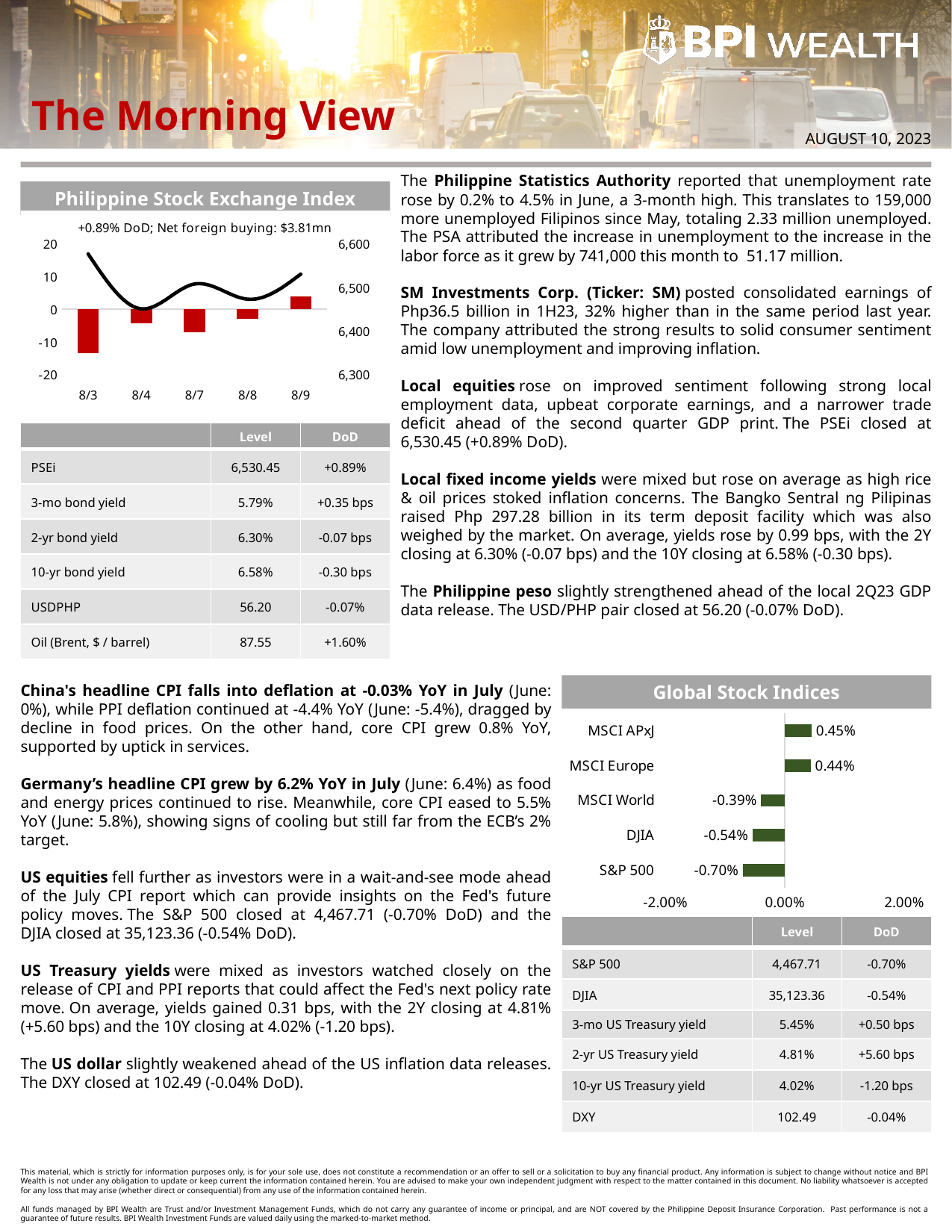
On the Global Stock Indices chart, what is the difference between the MSCI Europe value and the MSCI World value? 0.83 percentage points On the Global Stock Indices chart, what is the value for DJIA? -0.54% How many indices are plotted on the Global Stock Indices chart? 5 How many dates are shown on the x axis of the Philippine Stock Exchange Index chart? 5 On the Global Stock Indices chart, which is larger, the value for MSCI World or the value for DJIA? MSCI World On the Philippine Stock Exchange Index chart, is the bar value for 8/3 greater or less than -10? less On the Philippine Stock Exchange Index chart, is the line value for 8/3 greater or less than 6,500? greater On the Global Stock Indices chart, which index has the lowest value? S&P 500 On the Global Stock Indices chart, what is the value for MSCI APxJ? 0.45% On the Global Stock Indices chart, what is the value for S&P 500? -0.70% What kind of chart is the Global Stock Indices chart? Bar chart On the Global Stock Indices chart, which index has the highest value? MSCI APxJ